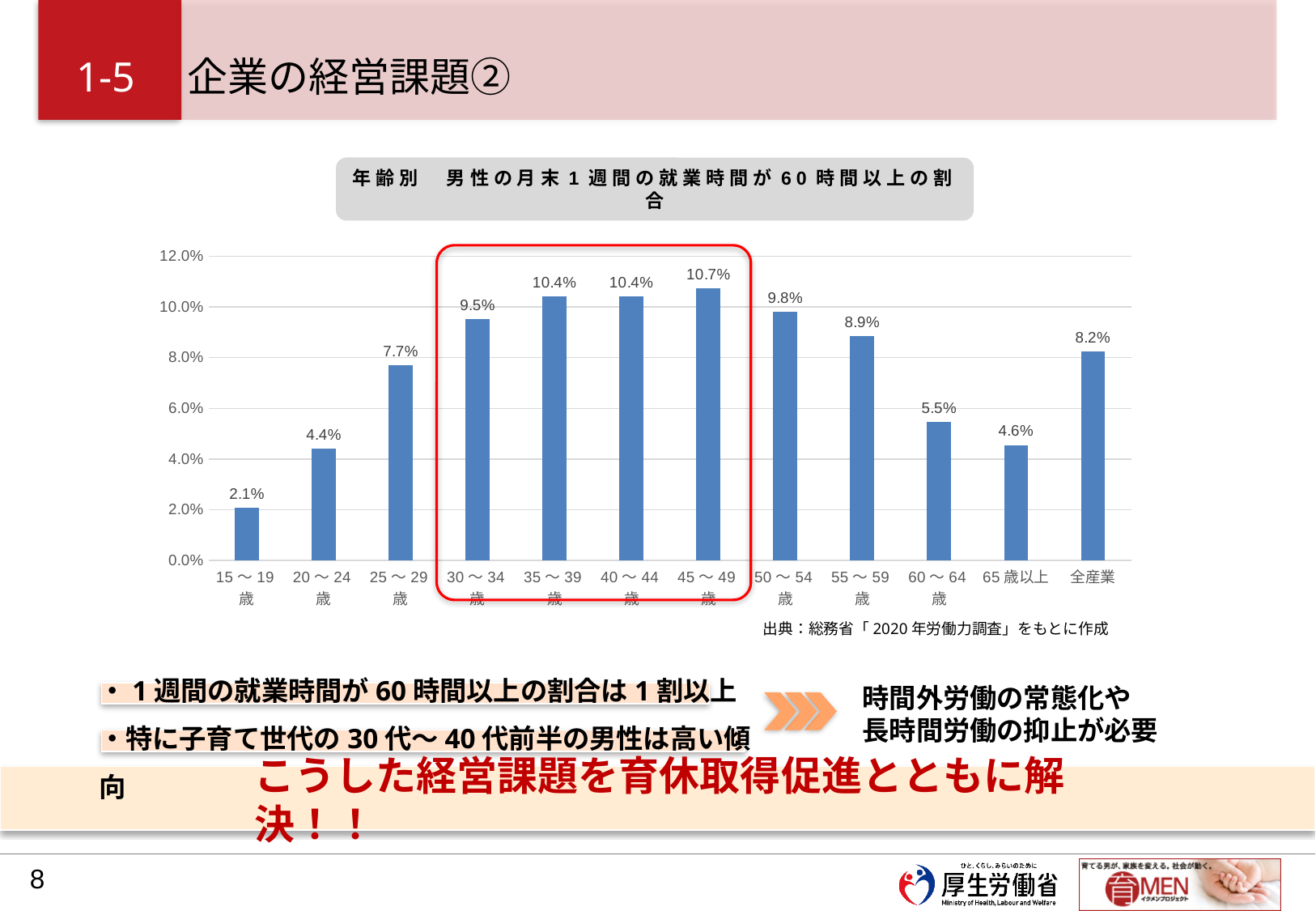
What kind of chart is shown on the slide? bar chart Which age group has the highest value? 45〜49歳 What is the value for the 45〜49歳 age group? 10.7% What is the difference between the values for 50〜54歳 and 55〜59歳? 0.9% What is the value for 全産業 (all industries)? 8.2% What is the value for the 15〜19歳 age group? 2.1% Which age group has the lowest value? 15〜19歳 Is the value for 65歳以上 greater or less than 6.0%? less Do the values rise or fall from 15〜19歳 to 45〜49歳? rise Which is larger, the value for 25〜29歳 or the value for 60〜64歳? 25〜29歳 What is the difference between the values for 45〜49歳 and 全産業? 2.5% How many categories are shown on the x axis? 12